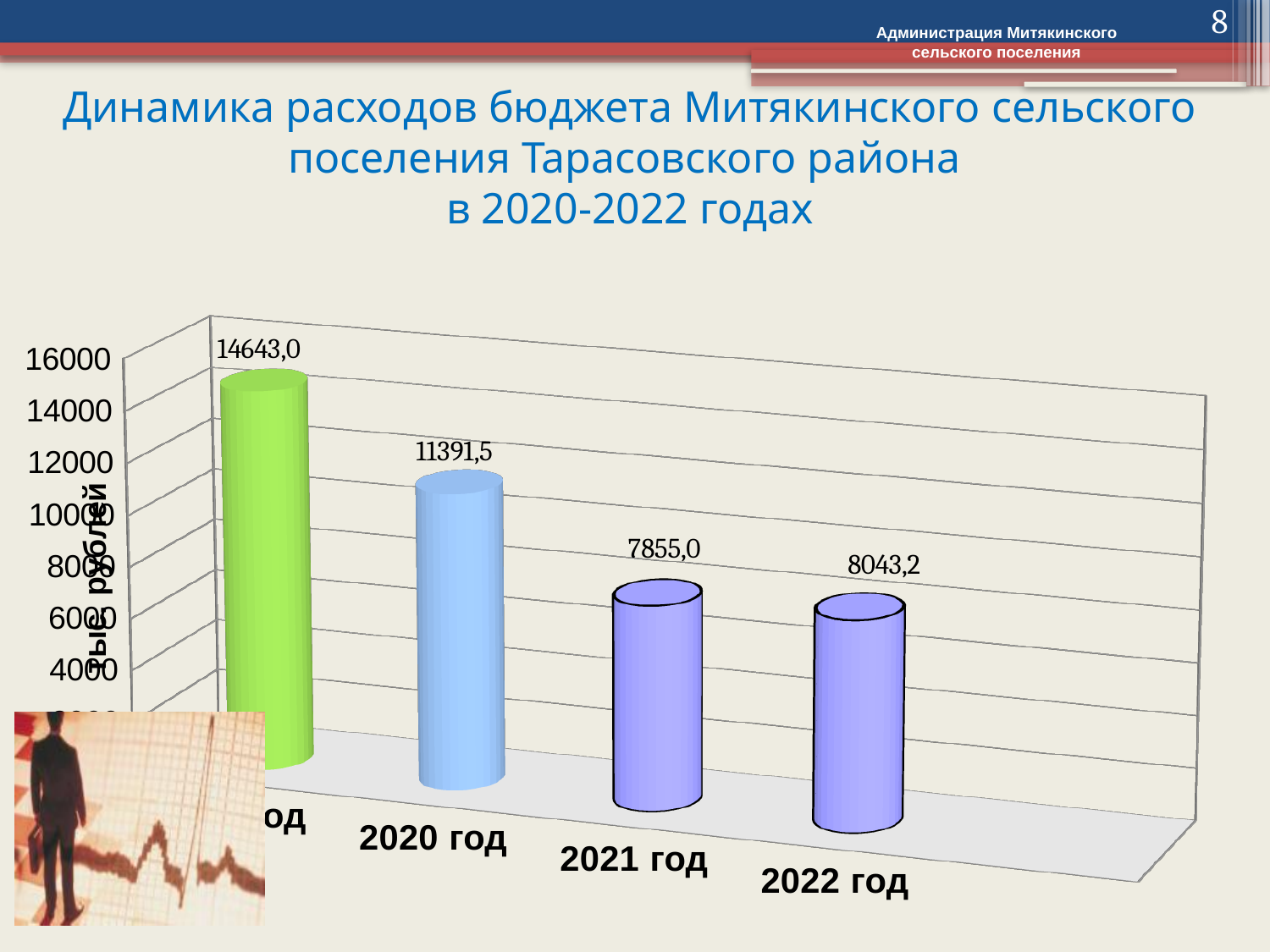
Which is larger, the value for 2021 год or the value for 2022 год? 2022 год What is the value for 2021 год? 7855,0 Is the value for 2021 год greater or less than 10000? less How many bars are shown on the chart? 4 Do the values rise or fall from 2020 год to 2021 год? fall What is the difference between the values for 2020 год and 2021 год? 3536,5 Is the value for 2020 год greater or less than 10000? greater What is the value for 2022 год? 8043,2 What kind of chart is shown on the slide? bar chart Which year has the lowest value on the chart? 2021 год What is the difference between the values for 2022 год and 2021 год? 188,2 What is the value for 2020 год? 11391,5